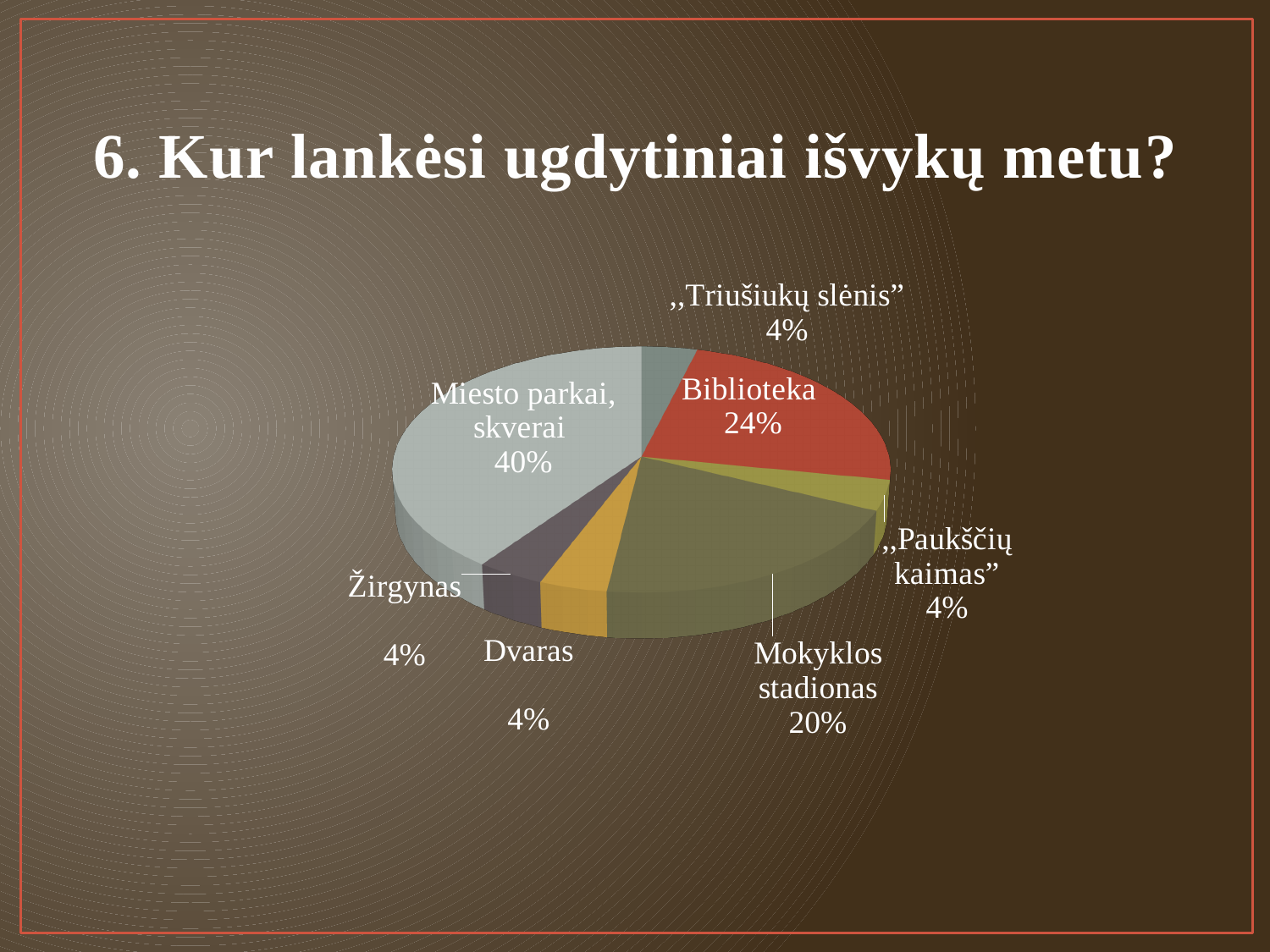
Which is larger, the share for Biblioteka or the share for Mokyklos stadionas? Biblioteka What share of the pie does Dvaras have? 4% What is the difference between the shares of Miesto parkai, skverai and Biblioteka? 16% How many slices does the pie chart have? 7 How many categories have a share of 4%? 4 What is the title of the slide above the chart? 6. Kur lankėsi ugdytiniai išvykų metu? What share of the pie does Miesto parkai, skverai have? 40% What is the combined share of Biblioteka and Mokyklos stadionas? 44% Which category has the largest slice of the pie? Miesto parkai, skverai What kind of chart is shown on the slide? pie chart What share of the pie does Mokyklos stadionas have? 20% What share of the pie does Biblioteka have? 24%